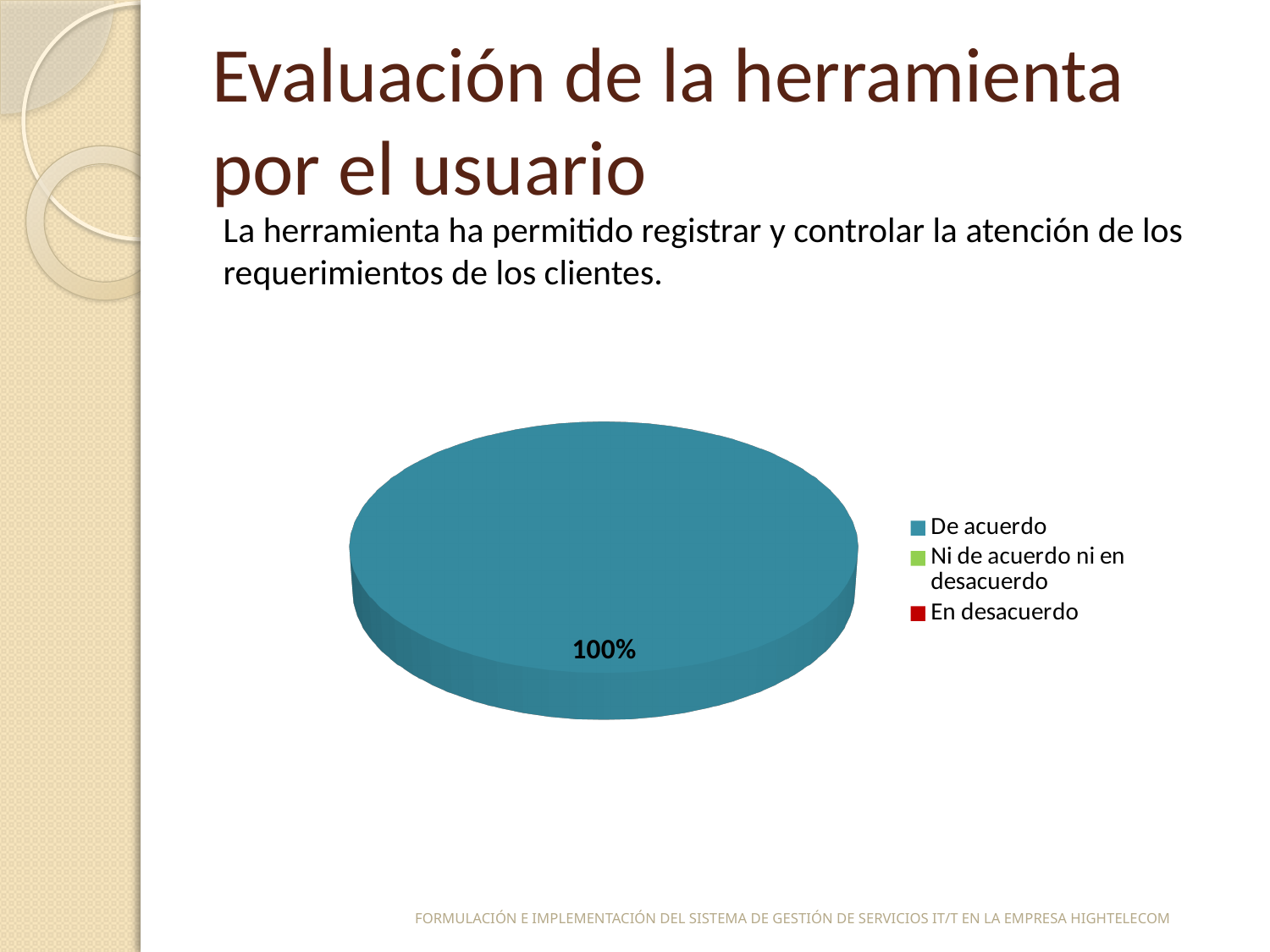
Which of the two, "De acuerdo" or "En desacuerdo", has the larger share of the pie? De acuerdo Which legend entry is shown in red? En desacuerdo How many entries does the chart legend list? 3 What kind of chart is shown on the slide? pie chart Which legend entry is shown in green? Ni de acuerdo ni en desacuerdo Which category accounts for the largest share of the pie? De acuerdo What is the only percentage label printed on the pie chart? 100% What share of the pie does the "De acuerdo" slice represent? 100%